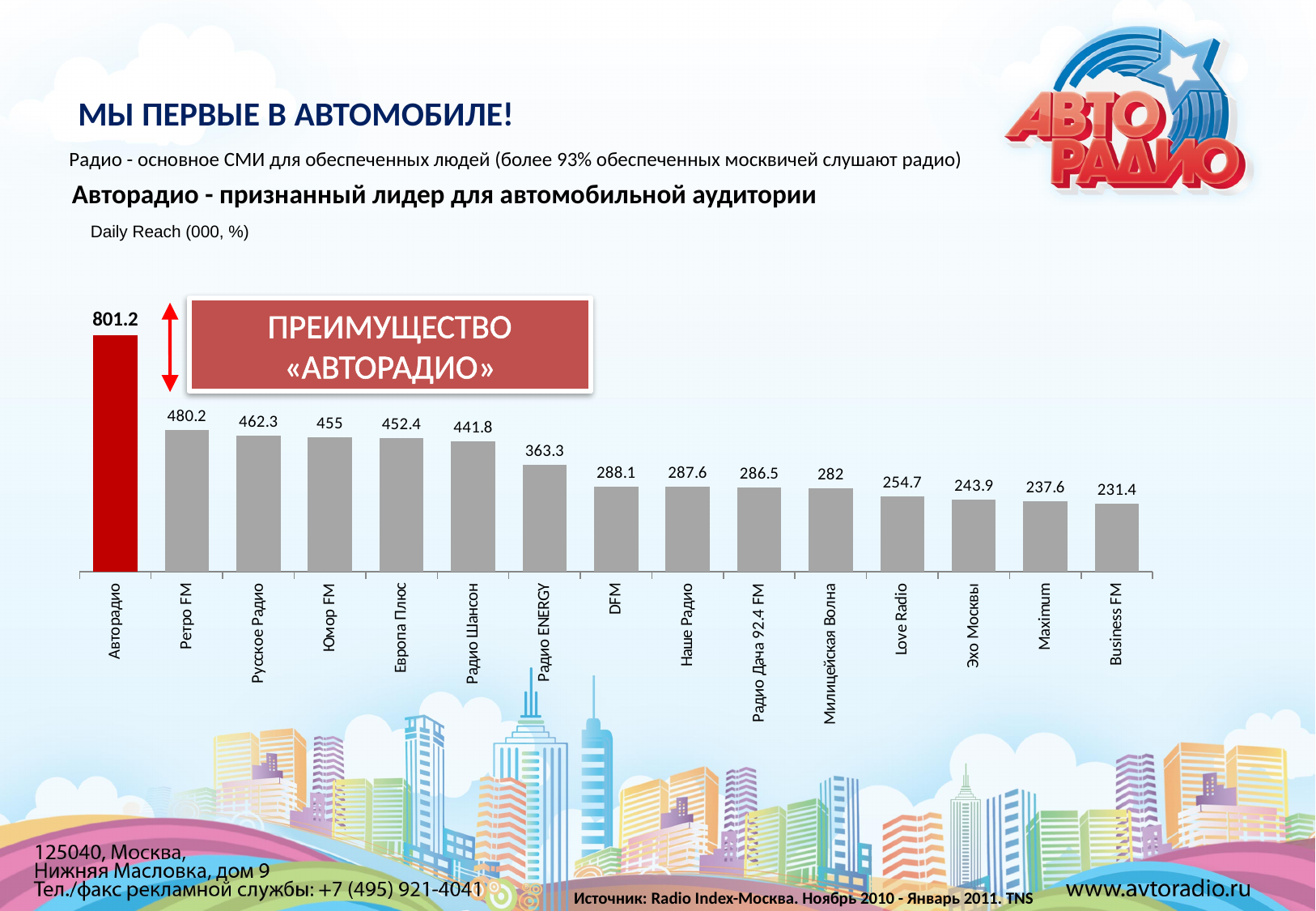
Do the values rise or fall from left to right along the x axis? Fall What kind of chart is shown on the slide? Bar chart Which radio station has the lowest Daily Reach value? Business FM What is the value shown for Business FM? 231.4 What is the value shown for Милицейская Волна? 282 How many radio stations are shown in the chart? 15 What is the difference between the values for Авторадио and Ретро FM? 321 Which radio station has the highest Daily Reach value? Авторадио Which has a larger value, Ретро FM or Русское Радио? Ретро FM What is the Daily Reach value for Авторадио? 801.2 What is the value shown for Радио ENERGY? 363.3 Which bar in the chart is coloured red? Авторадио